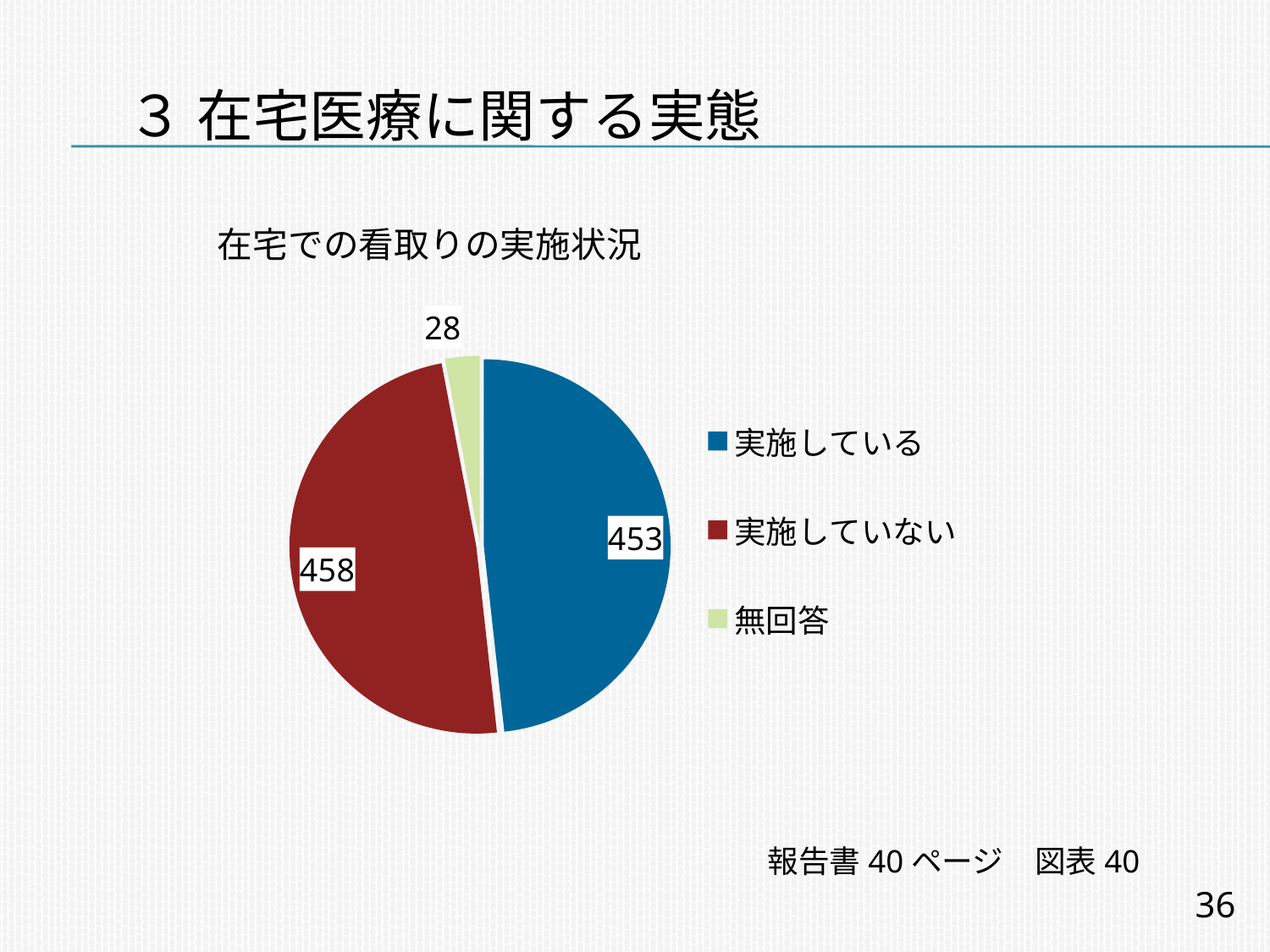
What is the value for 実施している? 453 What is the value for 無回答? 28 What is the value for 実施していない? 458 What type of chart is shown on the slide? pie chart How many categories does the pie chart have? 3 What is the total of all slices in the pie chart? 939 Which is larger, the value for 実施している or the value for 無回答? 実施している Which category has the smallest value? 無回答 Which colour represents 無回答 in the legend? light green What is the difference between the values for 実施していない and 実施している? 5 Which category has the largest value? 実施していない What is the title of the chart? 在宅での看取りの実施状況